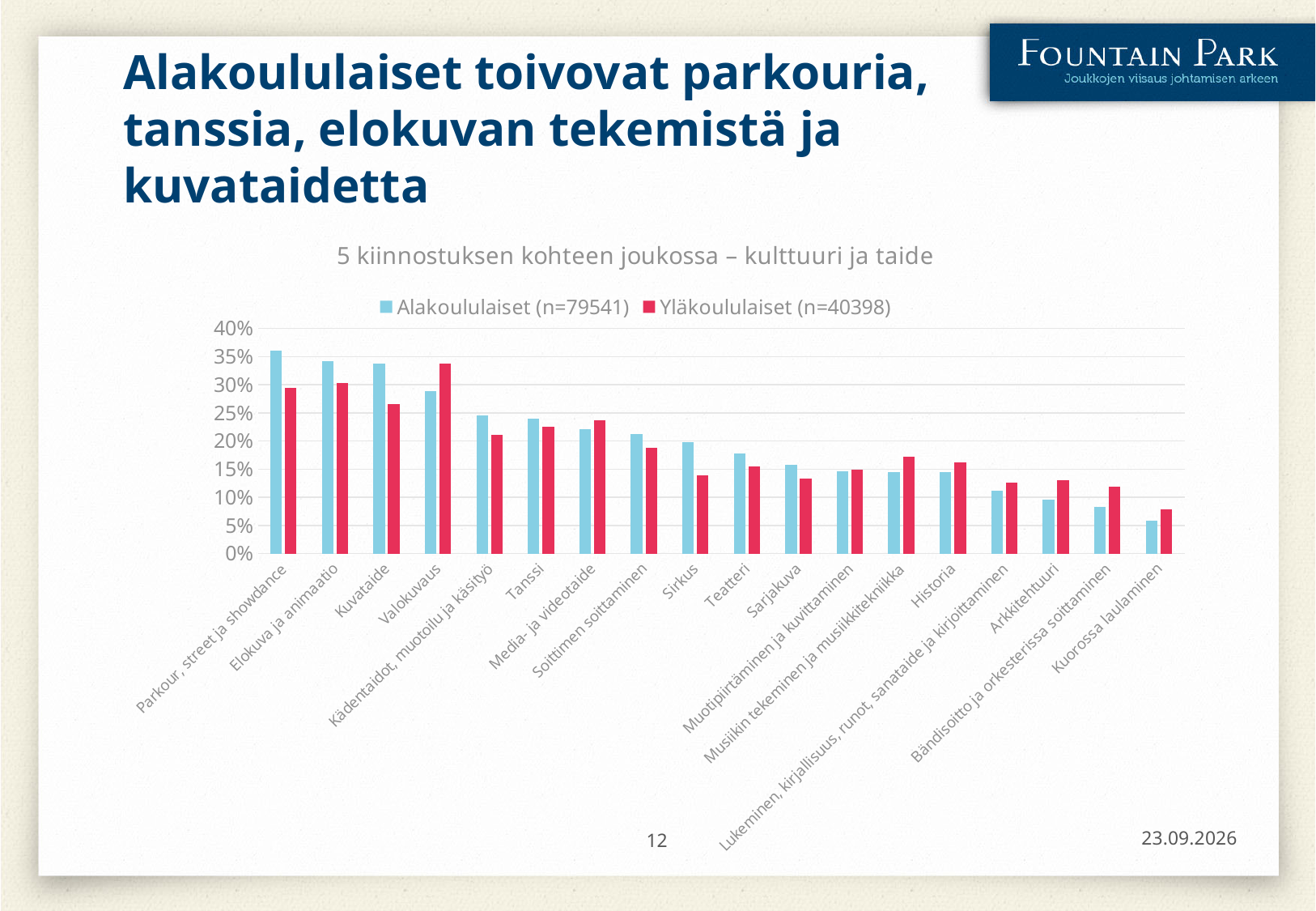
Is the Alakoululaiset value for Bändisoitto ja orkesterissa soittaminen greater or less than 10%? less How many series does the legend list? 2 What is the title of the chart? 5 kiinnostuksen kohteen joukossa – kulttuuri ja taide How many categories are shown on the x axis of the chart? 18 Which category has the highest value for Alakoululaiset (n=79541)? Parkour, street ja showdance For Sirkus, which series has the larger value, Alakoululaiset or Yläkoululaiset? Alakoululaiset Which category has the highest value for Yläkoululaiset (n=40398)? Valokuvaus For Valokuvaus, which series has the larger value, Alakoululaiset or Yläkoululaiset? Yläkoululaiset Do the Alakoululaiset values generally rise or fall from left to right along the x axis? fall Is the Alakoululaiset value for Parkour, street ja showdance greater or less than 30%? greater What kind of chart is shown on the slide? Bar chart Which category has the lowest value for Alakoululaiset (n=79541)? Kuorossa laulaminen